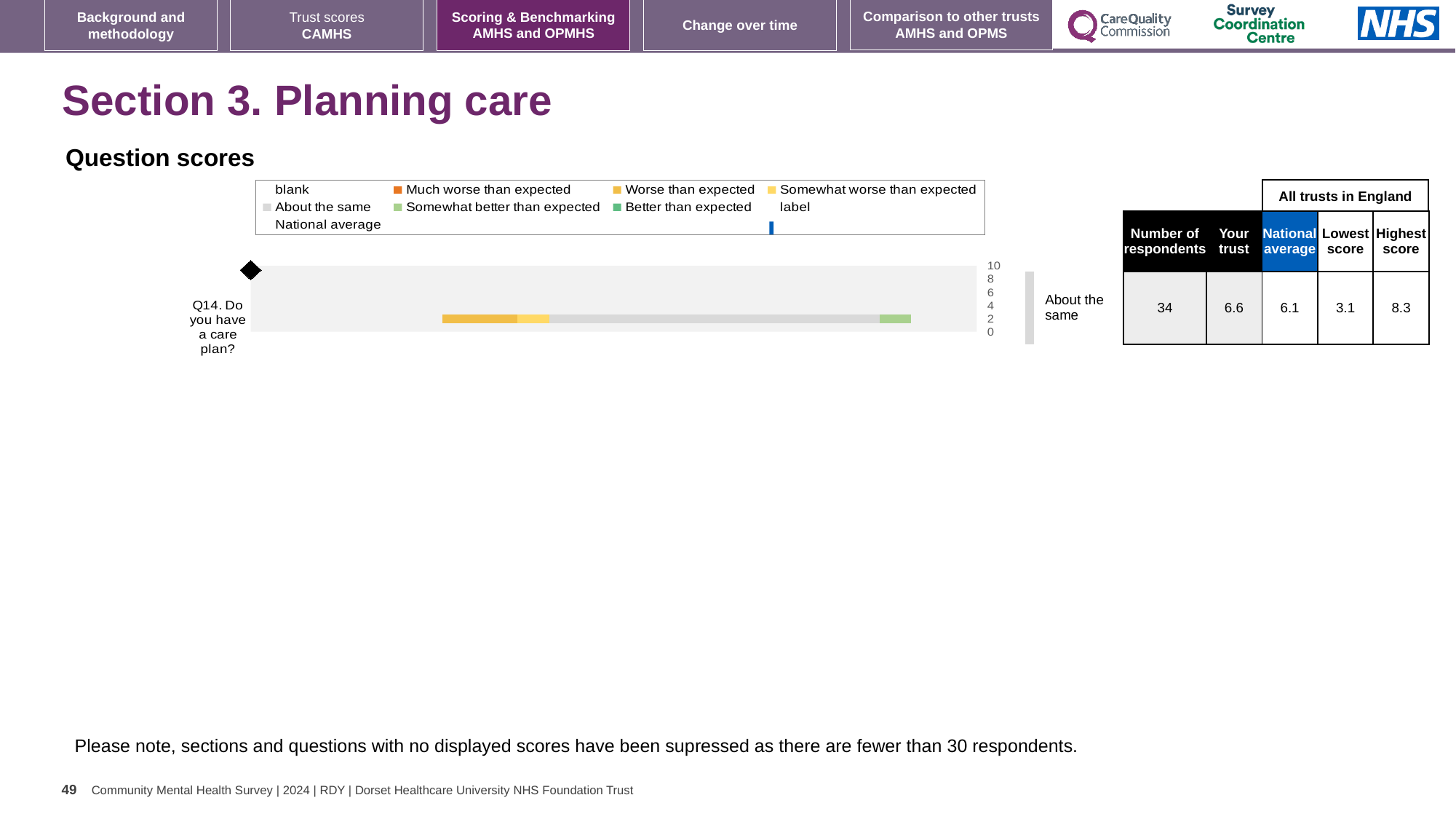
What is the maximum value shown on the score axis of the Q14 chart? 10 Which question is plotted in the question scores chart? Q14. Do you have a care plan? What benchmark category is shown to the right of the Q14 bar? About the same What is the difference between the highest and lowest scores for Q14 among all trusts in England? 5.2 What is the lowest score among all trusts in England for Q14? 3.1 How many questions are plotted in the question scores chart? 1 What is the highest score among all trusts in England for Q14? 8.3 What is the 'Your trust' score for Q14 in the table beside the chart? 6.6 What kind of chart is used to show the Q14 question score? bar chart How many respondents answered Q14? 34 What is the national average score for Q14 in the table beside the chart? 6.1 For Q14, which is larger: the 'Your trust' score or the national average? Your trust